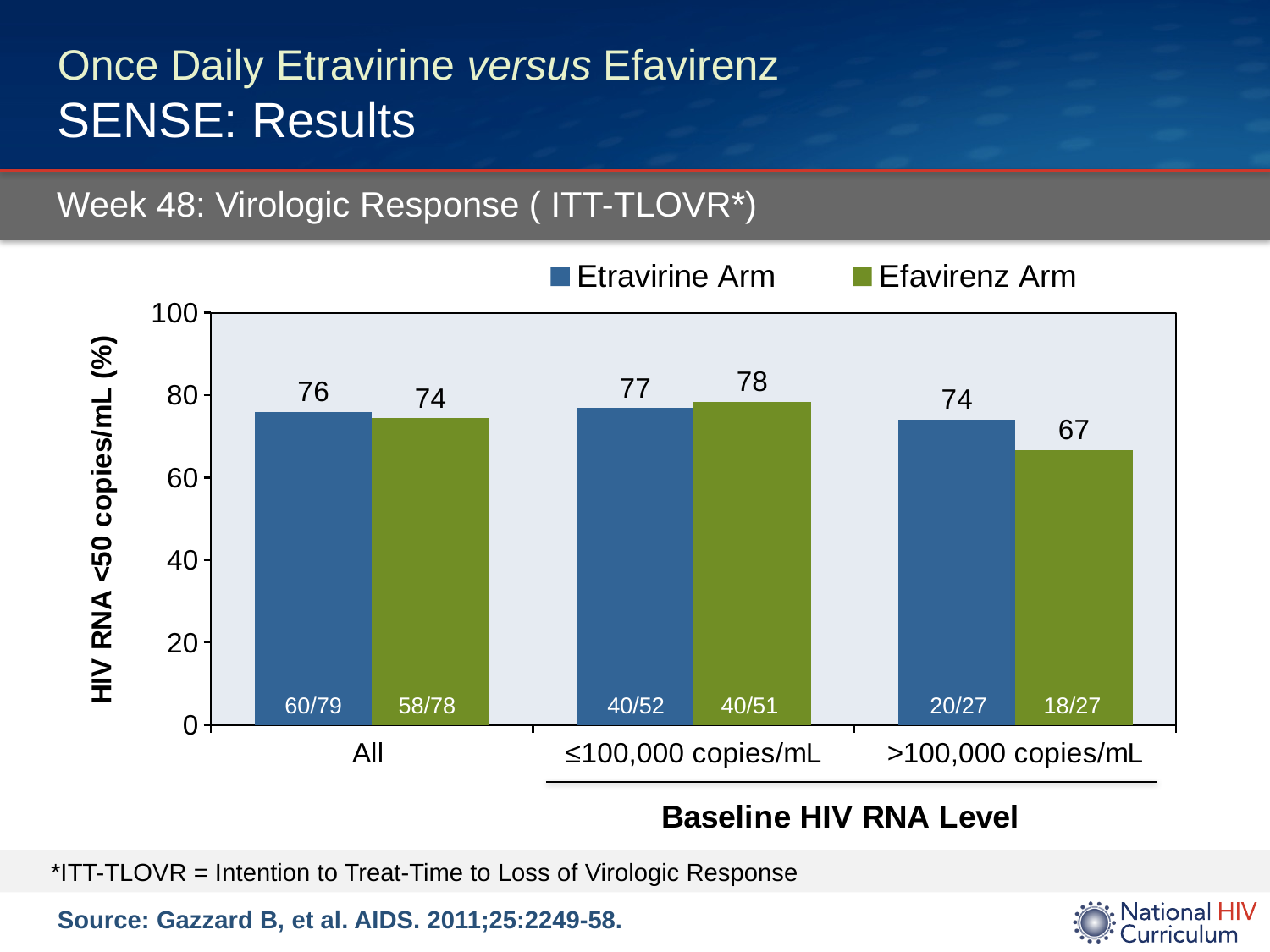
How many categories are shown on the x axis? 3 How many series does the legend list? 2 What is the value for the Etravirine Arm in the All category? 76 Is the value for the Efavirenz Arm in the >100,000 copies/mL category greater or less than 80? less What kind of chart is shown on the slide? bar chart In the All category, which arm has the larger value? Etravirine Arm What is the value for the Efavirenz Arm in the ≤100,000 copies/mL category? 78 What is the difference between the Etravirine Arm and Efavirenz Arm values in the >100,000 copies/mL category? 7 What is the value for the Efavirenz Arm in the >100,000 copies/mL category? 67 Which category has the lowest value for the Efavirenz Arm? >100,000 copies/mL Which category has the highest value for the Etravirine Arm? ≤100,000 copies/mL What is the y-axis label of the chart? HIV RNA <50 copies/mL (%)